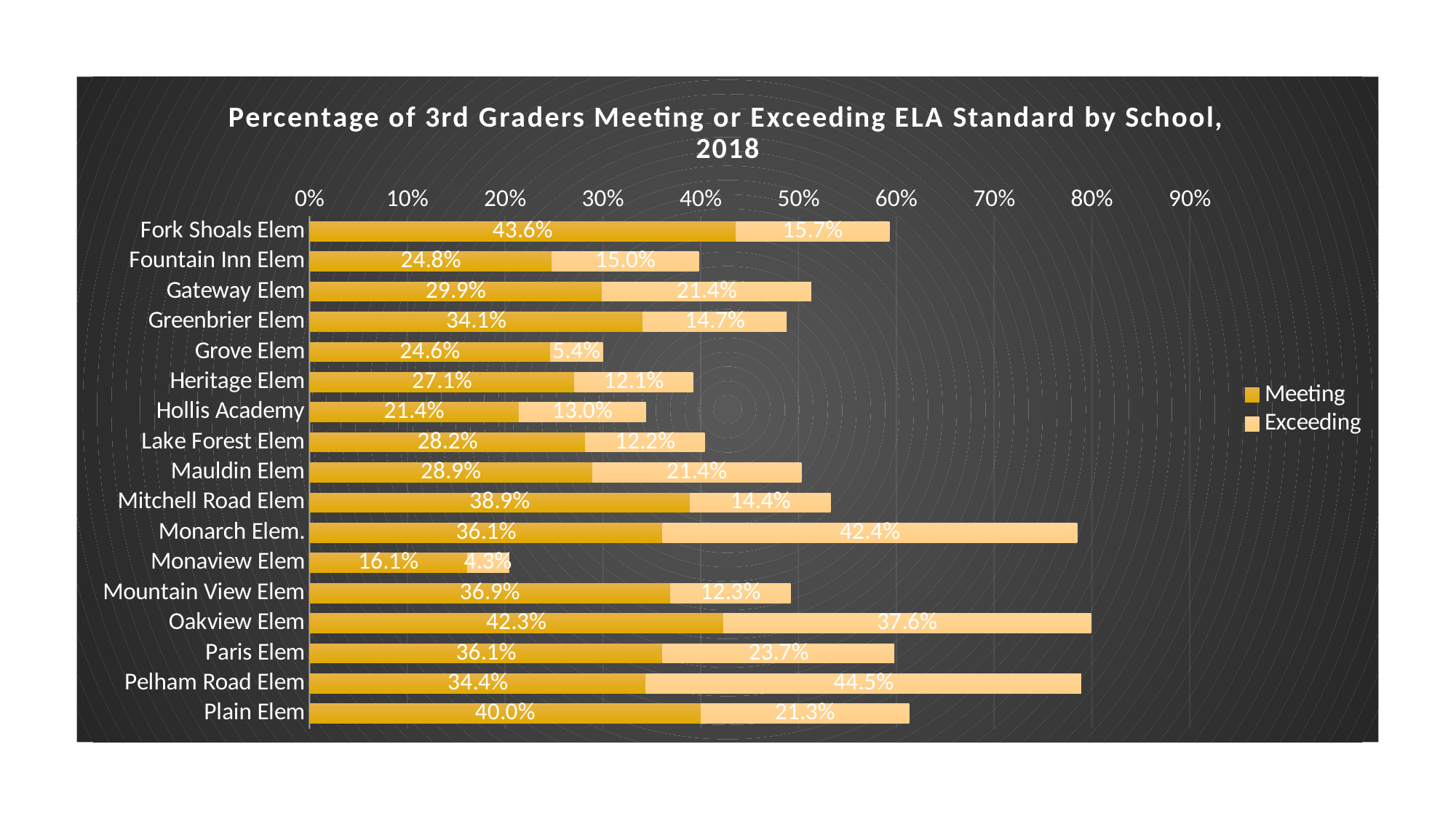
What is the total of the stacked bar for Grove Elem? 30.0% What kind of chart is shown on the slide? Stacked bar chart What percentage of 3rd graders at Fork Shoals Elem are in the Meeting category? 43.6% Which school has the lowest Exceeding percentage? Monaview Elem What is the Exceeding value for Pelham Road Elem? 44.5% Which school has the highest Exceeding percentage? Pelham Road Elem What is the difference between the Exceeding values for Monarch Elem. and Oakview Elem? 4.8% How many schools are shown on the chart? 17 Which school has the highest Meeting percentage? Fork Shoals Elem What is the Meeting value for Monaview Elem? 16.1% Which is larger, the Meeting value for Plain Elem or the Meeting value for Mitchell Road Elem? Plain Elem How many series does the legend list? 2